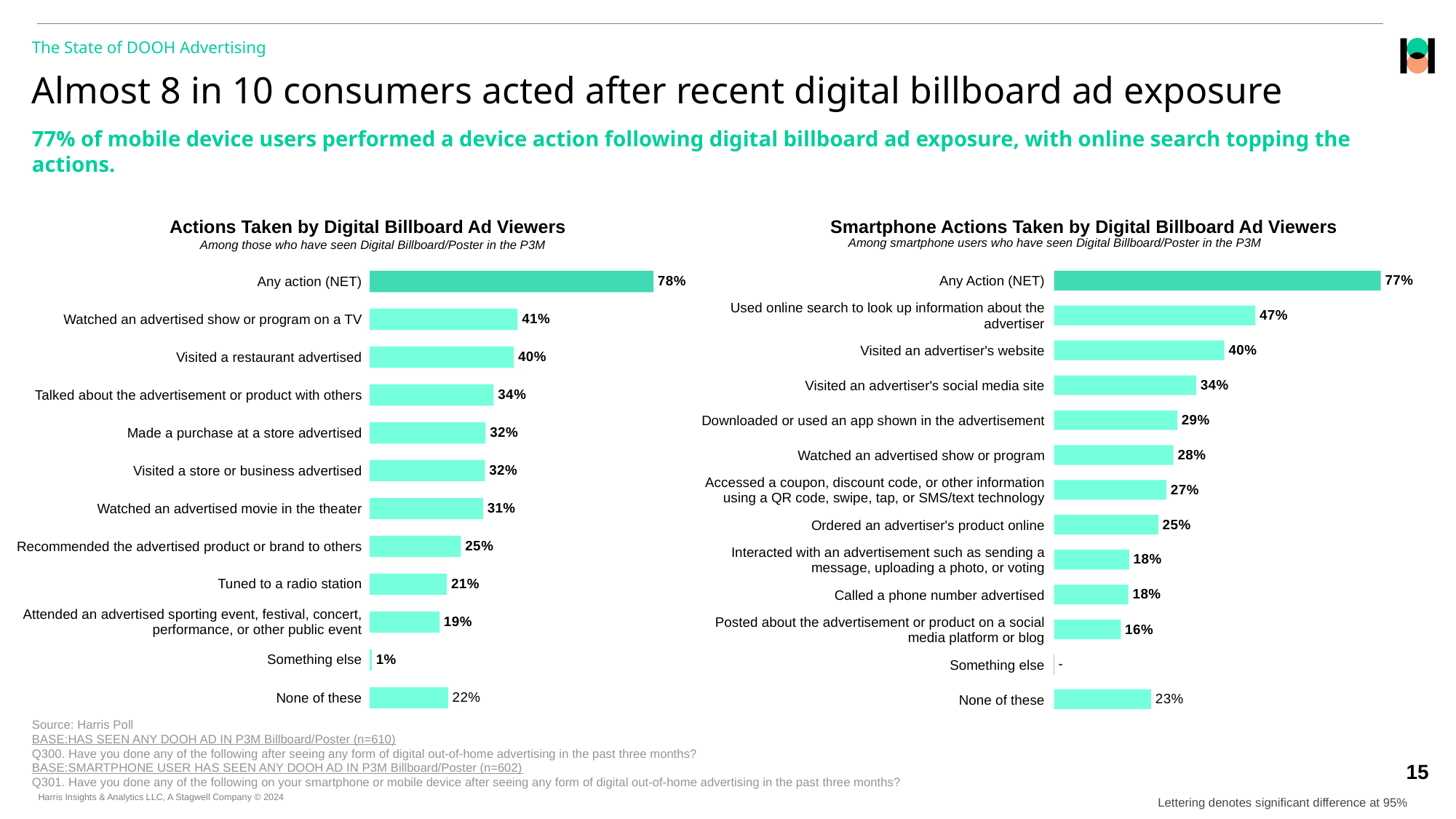
In the 'Smartphone Actions Taken by Digital Billboard Ad Viewers' chart, which category has the highest value? Any Action (NET) In the 'Smartphone Actions Taken by Digital Billboard Ad Viewers' chart, what is the difference between 'Used online search to look up information about the advertiser' and 'Ordered an advertiser's product online'? 22% In the 'Actions Taken by Digital Billboard Ad Viewers' chart, which category has the lowest value? Something else In the 'Actions Taken by Digital Billboard Ad Viewers' chart, what is the difference between 'Watched an advertised show or program on a TV' and 'Tuned to a radio station'? 20% What kind of chart is the 'Smartphone Actions Taken by Digital Billboard Ad Viewers' chart? Bar chart In the 'Smartphone Actions Taken by Digital Billboard Ad Viewers' chart, which is larger: 'Downloaded or used an app shown in the advertisement' or 'Posted about the advertisement or product on a social media platform or blog'? Downloaded or used an app shown in the advertisement How many categories are shown in the 'Actions Taken by Digital Billboard Ad Viewers' chart? 12 In the 'Actions Taken by Digital Billboard Ad Viewers' chart, which is larger: 'Watched an advertised movie in the theater' or 'Recommended the advertised product or brand to others'? Watched an advertised movie in the theater In the 'Actions Taken by Digital Billboard Ad Viewers' chart, what is the value for 'Visited a restaurant advertised'? 40% In the 'Smartphone Actions Taken by Digital Billboard Ad Viewers' chart, what is the value for 'None of these'? 23% In the 'Smartphone Actions Taken by Digital Billboard Ad Viewers' chart, what is the value for 'Visited an advertiser's social media site'? 34% What is the subtitle shown under the title of the 'Actions Taken by Digital Billboard Ad Viewers' chart? Among those who have seen Digital Billboard/Poster in the P3M